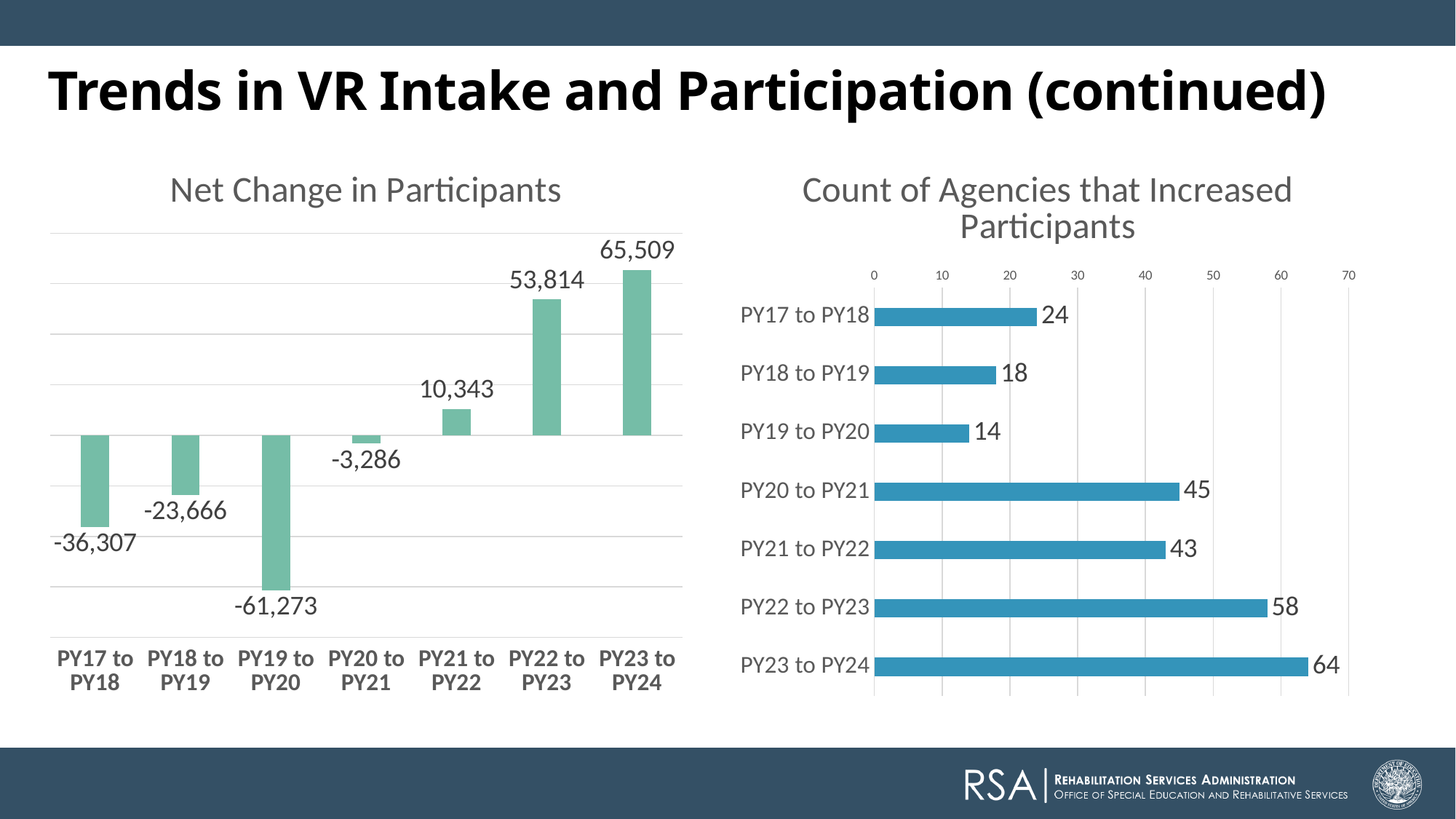
In the 'Count of Agencies that Increased Participants' chart, what is the highest value shown on the horizontal axis? 70 In the 'Count of Agencies that Increased Participants' chart, which period has the highest count? PY23 to PY24 In the 'Net Change in Participants' chart, what is the value for PY19 to PY20? -61,273 In the 'Count of Agencies that Increased Participants' chart, what is the value for PY20 to PY21? 45 In the 'Net Change in Participants' chart, what is the value for PY23 to PY24? 65,509 In the 'Net Change in Participants' chart, how many periods are shown on the x axis? 7 What kind of chart is the 'Count of Agencies that Increased Participants' chart? Bar chart In the 'Net Change in Participants' chart, what is the difference between the PY23 to PY24 value and the PY22 to PY23 value? 11,695 In the 'Count of Agencies that Increased Participants' chart, which period has the lowest count? PY19 to PY20 In the 'Net Change in Participants' chart, which period has the lowest value? PY19 to PY20 In the 'Net Change in Participants' chart, is the value for PY21 to PY22 larger than the value for PY20 to PY21? Yes In the 'Count of Agencies that Increased Participants' chart, what is the difference between the PY22 to PY23 count and the PY18 to PY19 count? 40